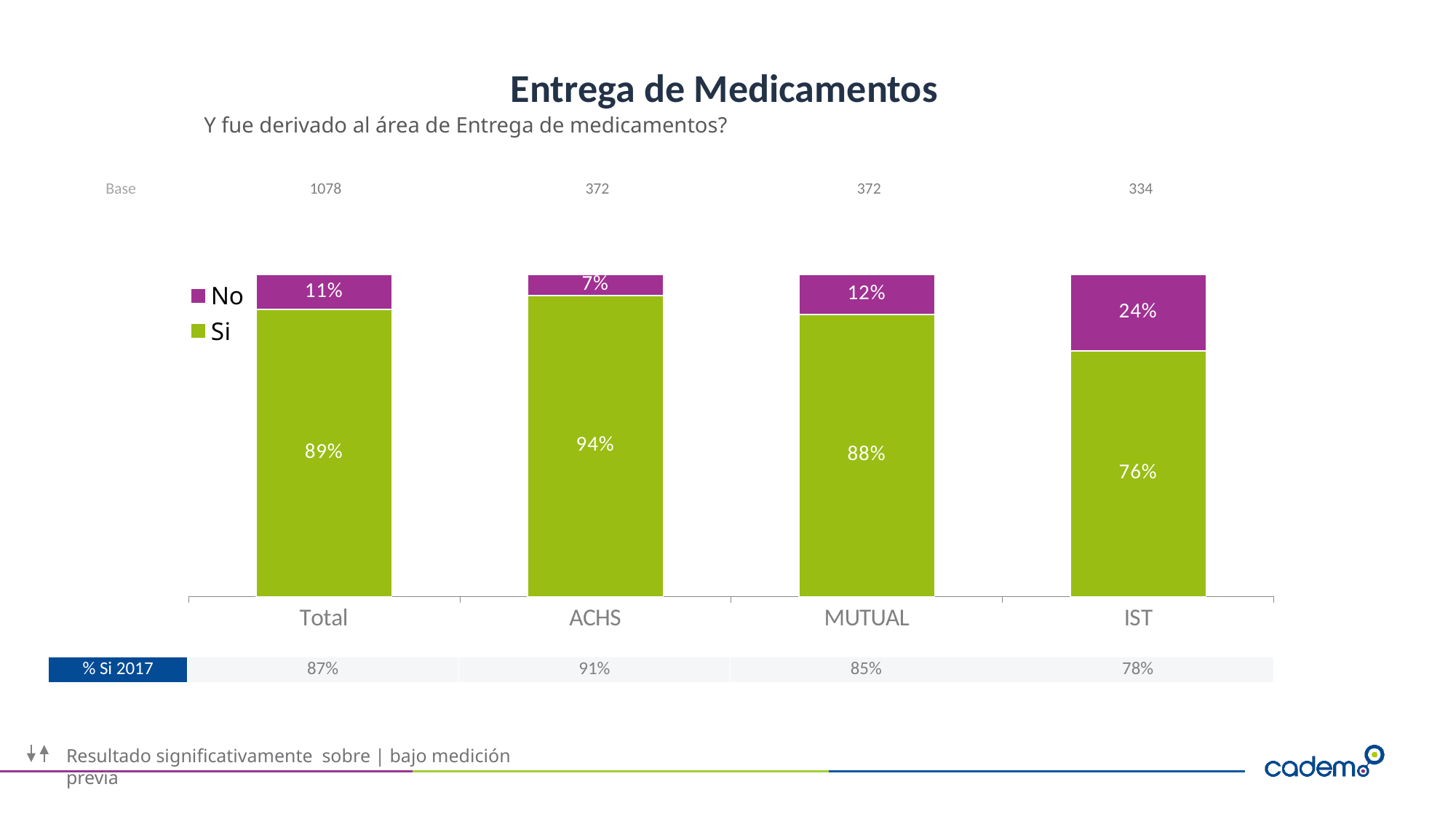
What kind of chart is shown on the slide? Stacked bar chart What is the 'No' value for MUTUAL? 12% Which category has the highest 'Si' value? ACHS What is the total of the stacked bar for MUTUAL? 100% Which category has the lowest 'Si' value? IST How many series does the legend list? 2 Which is larger, the 'No' value for Total or the 'No' value for MUTUAL? MUTUAL How many categories are shown on the x axis? 4 What is the 'Si' value for ACHS? 94% What is the difference between the 'Si' values for ACHS and IST? 18% What is the 'Si' value for Total? 89% What is the 'No' value for IST? 24%